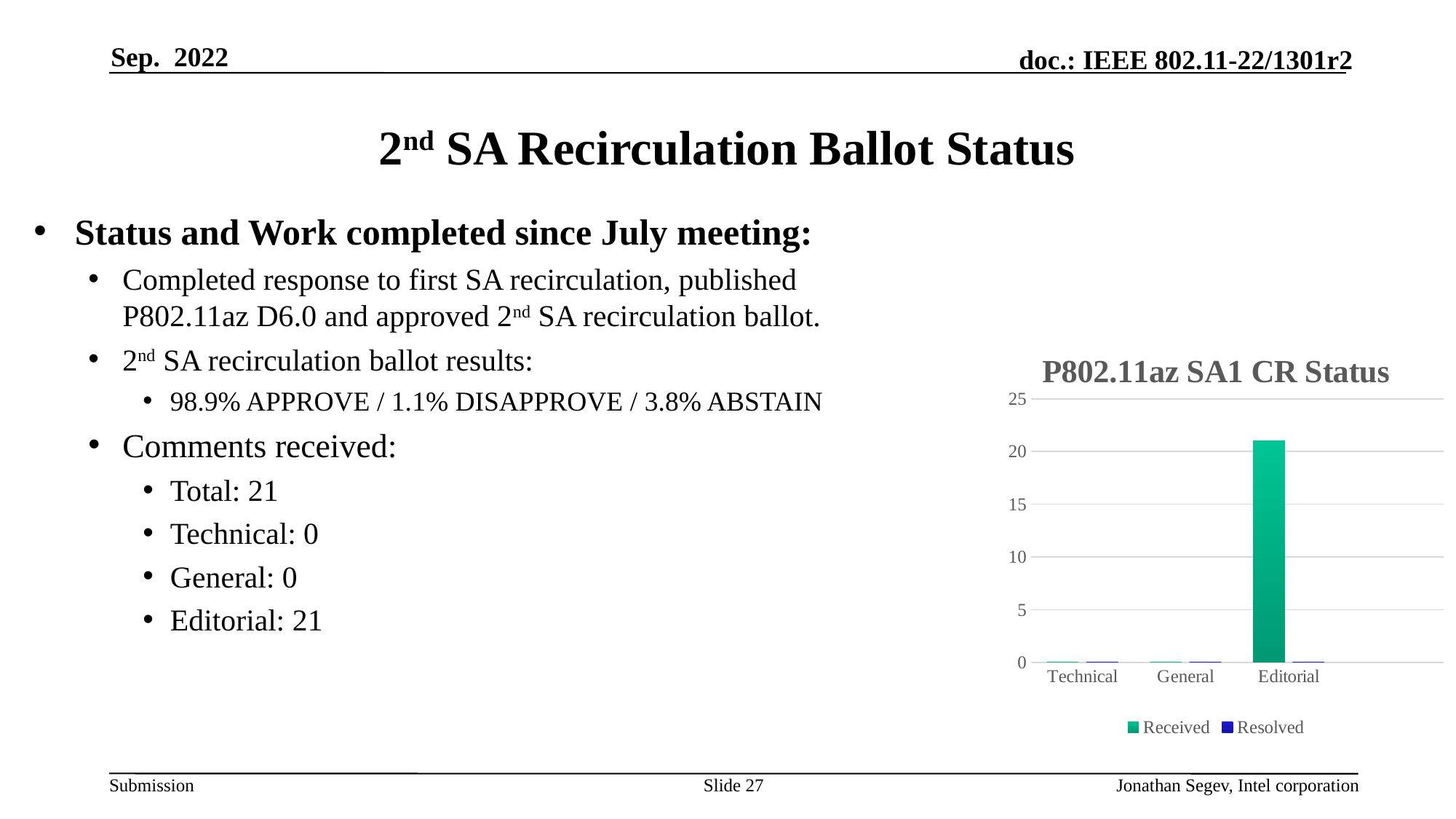
Which category has the highest Received value in the chart? Editorial What is the Received value for General in the chart? 0 What is the Received value for Technical in the chart? 0 What is the maximum value shown on the chart's vertical axis? 25 Is the Received value for Editorial greater or less than 20? greater Is the Received value for Editorial greater or less than 25? less How many categories are shown on the x axis of the chart? 3 How many series does the chart legend list? 2 Which is larger in the chart, the Received value for Editorial or the Received value for Technical? Editorial What kind of chart is shown on the slide? bar chart Which series are listed in the chart legend? Received and Resolved What is the title of the chart on the slide? P802.11az SA1 CR Status